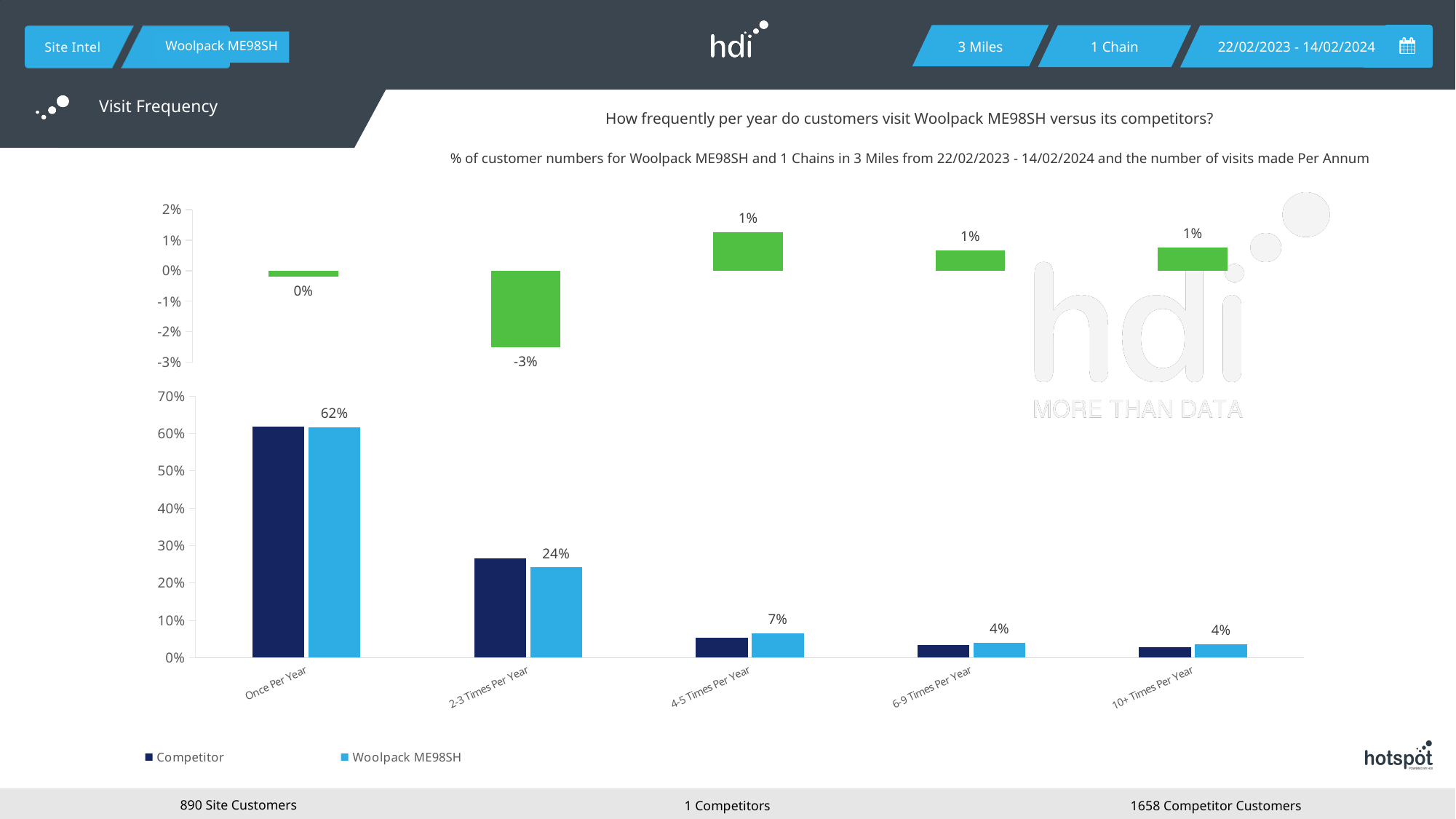
In the bottom bar chart, how many visit frequency categories are shown on the x axis? 5 In the bottom bar chart, is the Competitor value for 4-5 Times Per Year greater or less than 10%? less In the bottom bar chart, how many series does the legend list? 2 In the bottom bar chart, what is the difference between the Woolpack ME98SH values for Once Per Year and 2-3 Times Per Year? 38% In the bottom bar chart, is the Competitor value for Once Per Year greater or less than 50%? greater What kind of chart is the bottom chart? Bar chart In the bottom bar chart, what is the value for Woolpack ME98SH for Once Per Year? 62% In the bottom bar chart, what is the value for Woolpack ME98SH for 2-3 Times Per Year? 24% In the top chart, what is the value shown for 2-3 Times Per Year? -3% In the top chart, which category has the lowest value? 2-3 Times Per Year In the bottom bar chart, what is the value for Woolpack ME98SH for 4-5 Times Per Year? 7% In the bottom bar chart, which visit frequency category has the highest Woolpack ME98SH value? Once Per Year